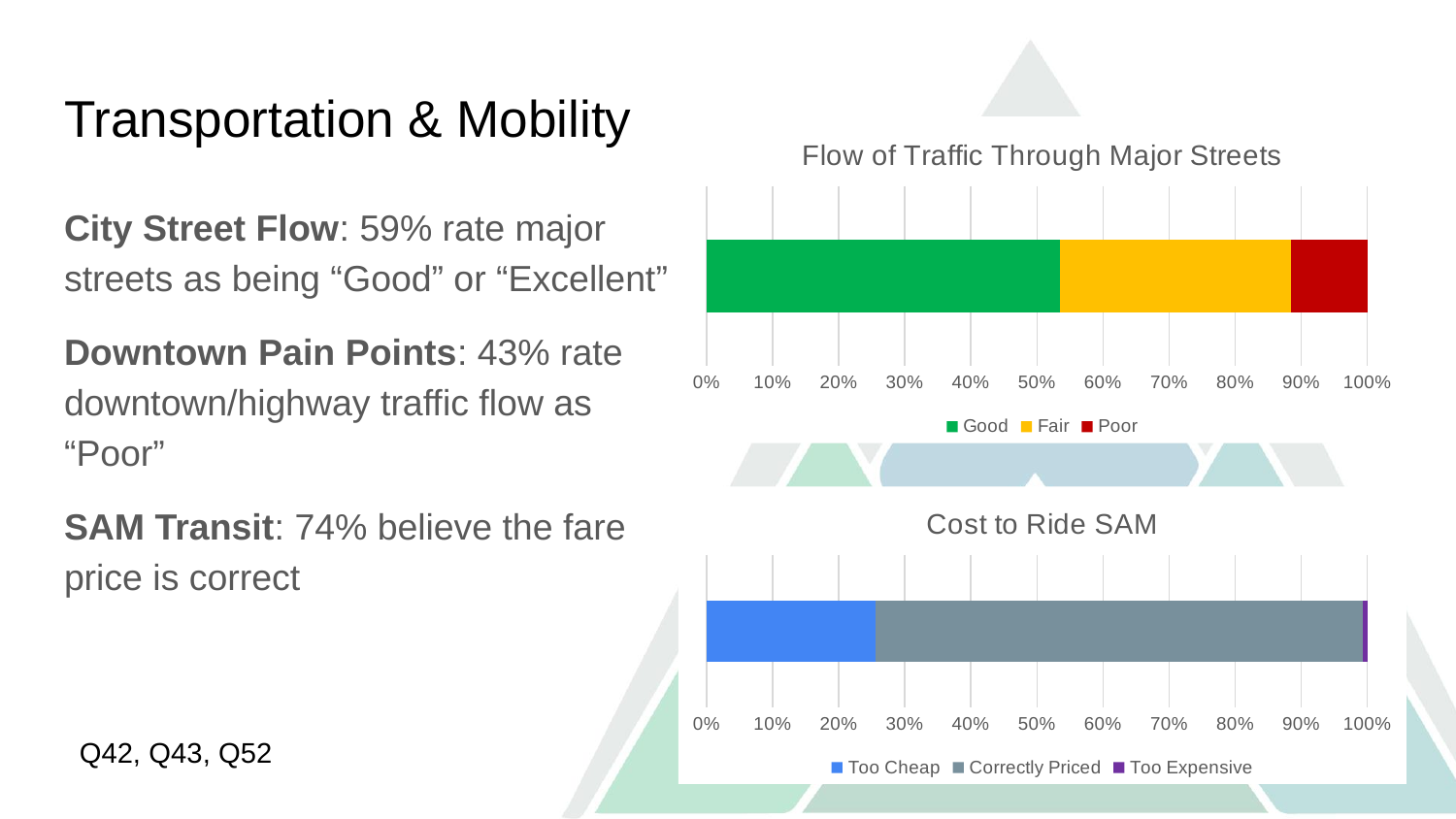
In "Flow of Traffic Through Major Streets", is the Poor segment greater or less than 20%? less How many series does the legend of "Cost to Ride SAM" list? 3 In "Cost to Ride SAM", is the Too Cheap segment greater or less than 30%? less In "Flow of Traffic Through Major Streets", which series has the smallest segment? Poor In "Flow of Traffic Through Major Streets", which segment is larger, Fair or Poor? Fair In "Flow of Traffic Through Major Streets", which series has the largest segment? Good In "Cost to Ride SAM", which series has the largest segment? Correctly Priced What kind of chart is "Flow of Traffic Through Major Streets"? bar chart What kind of chart is "Cost to Ride SAM"? bar chart In "Flow of Traffic Through Major Streets", is the Good segment greater or less than 50%? greater How many series does the legend of "Flow of Traffic Through Major Streets" list? 3 In "Cost to Ride SAM", what colour represents Too Expensive in the legend? purple